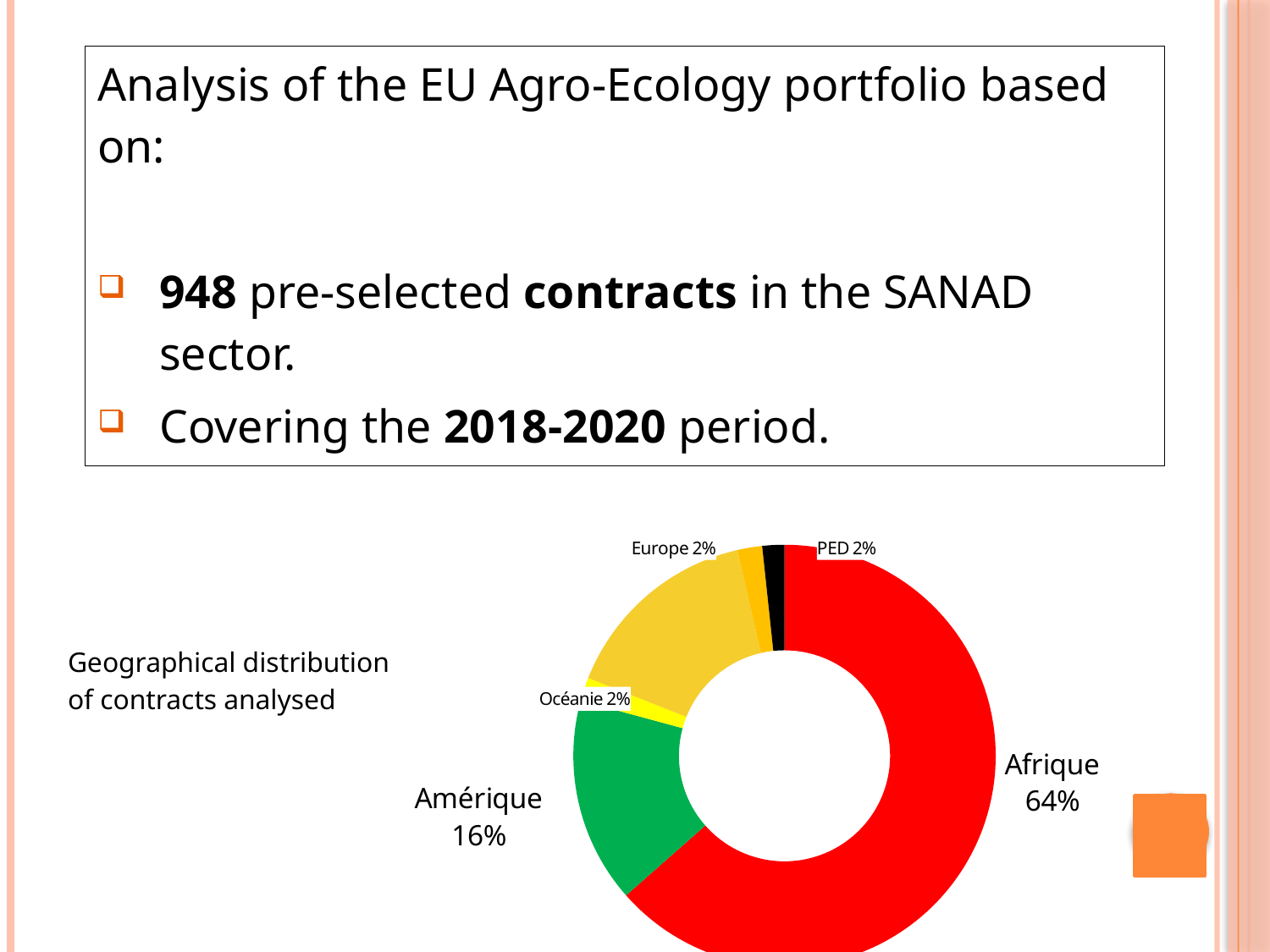
Which region has the largest share of contracts analysed? Afrique How many percentage points larger is the Afrique share than the Amérique share? 48 percentage points Which is larger, the share for Afrique or the share for Amérique? Afrique What colour is the Afrique slice of the chart? Red What caption describes the chart on the slide? Geographical distribution of contracts analysed What percentage of contracts analysed are in Amérique? 16% What percentage does the Océanie slice represent? 2% What percentage of contracts analysed are in Afrique? 64% What percentage does the PED slice represent? 2% What kind of chart is used to show the geographical distribution of contracts? Doughnut chart What share of the chart does the Amérique slice take up? 16% What percentage does the Europe slice represent? 2%